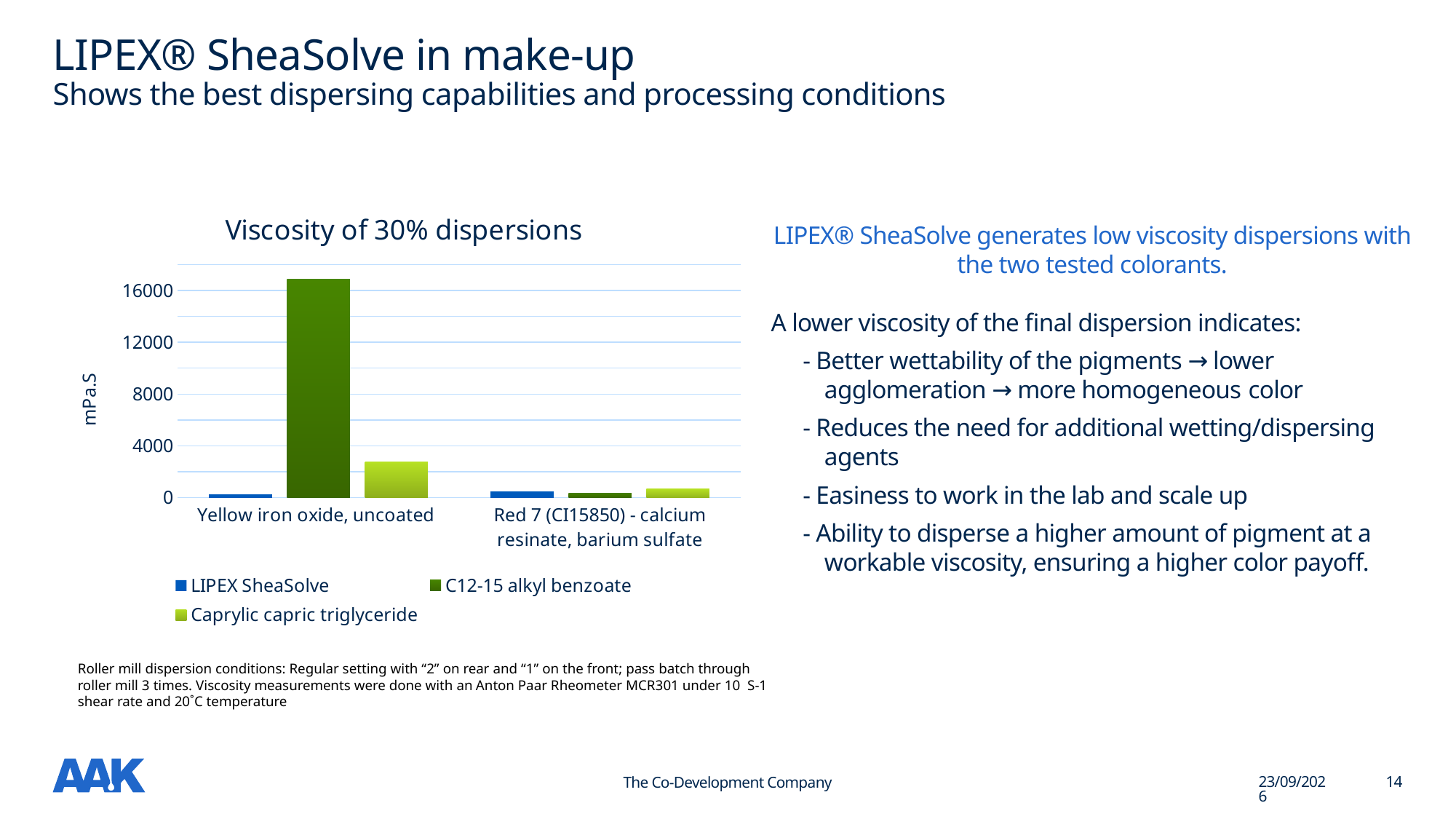
Which series has the lowest viscosity for Yellow iron oxide, uncoated? LIPEX SheaSolve For Yellow iron oxide, uncoated, which is larger: the viscosity with Caprylic capric triglyceride or with LIPEX SheaSolve? Caprylic capric triglyceride What kind of chart is shown on the slide? Bar chart Is the viscosity of Caprylic capric triglyceride for Yellow iron oxide, uncoated greater or less than 4000? less How many pigment categories are shown on the x axis of the chart? 2 Which series has the highest viscosity for Yellow iron oxide, uncoated? C12-15 alkyl benzoate Is the viscosity of C12-15 alkyl benzoate for Yellow iron oxide, uncoated greater or less than 16000? greater What unit is shown on the y axis of the chart? mPa.S For C12-15 alkyl benzoate, which category has the larger viscosity: Yellow iron oxide, uncoated or Red 7 (CI15850) - calcium resinate, barium sulfate? Yellow iron oxide, uncoated What is the title of the chart? Viscosity of 30% dispersions Is the viscosity of LIPEX SheaSolve for Red 7 (CI15850) - calcium resinate, barium sulfate greater or less than 4000? less How many series does the chart legend list? 3